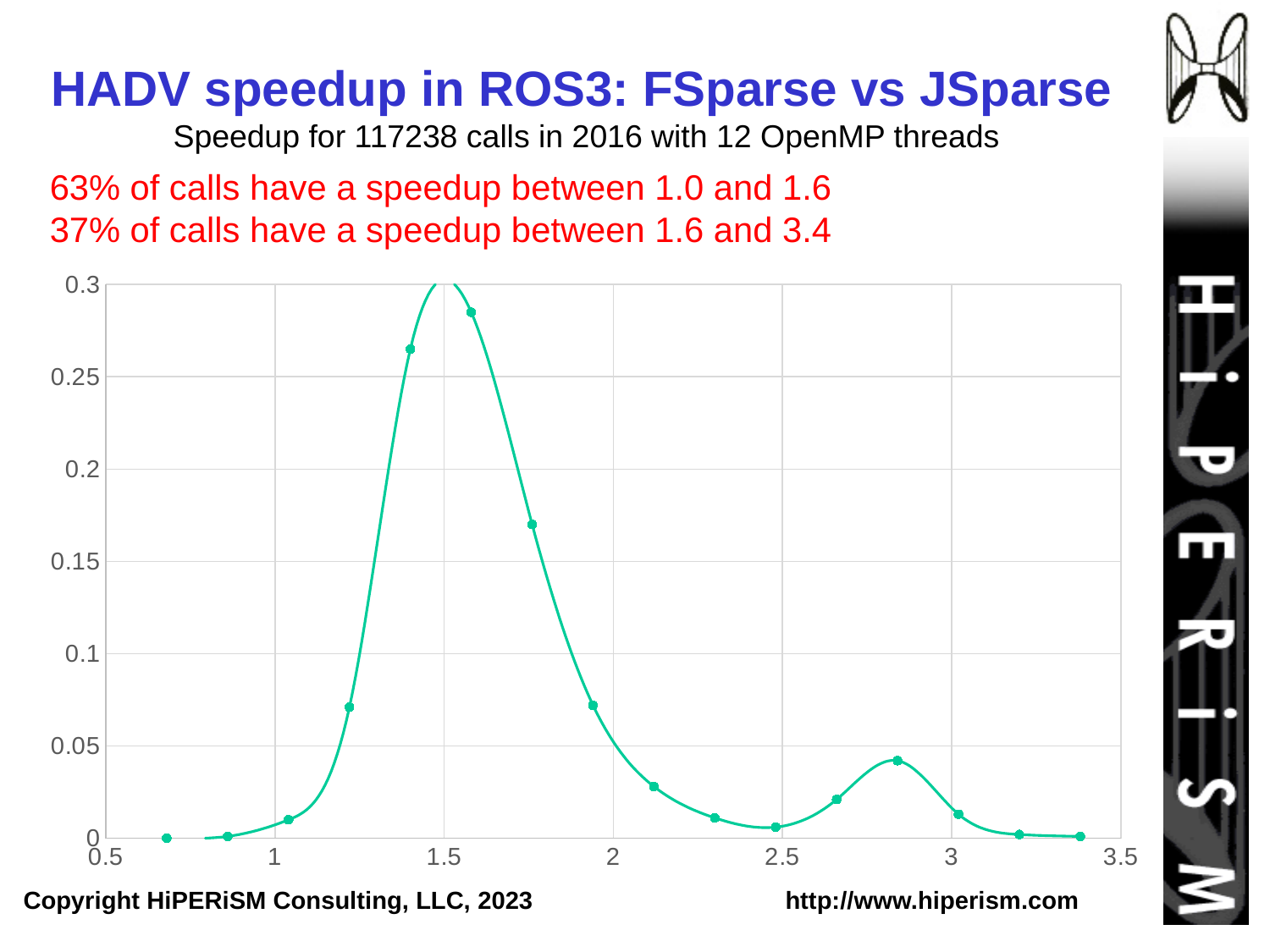
What is the title of the slide containing the chart? HADV speedup in ROS3: FSparse vs JSparse Is the value of the plotted point just below x = 1.25 greater or less than 0.1? less Do the plotted values rise or fall as x increases from 1.6 to 2.5? fall Is the value of the plotted point near x = 2.5 greater or less than 0.05? less Which is larger: the plotted value near x = 2.85 or the plotted value near x = 2.5? the value near x = 2.85 Is the value of the highest plotted point greater or less than 0.25? greater According to the chart subtitle, how many OpenMP threads were used? 12 Do the plotted values rise or fall as x increases from 1.0 to 1.5? rise Which is larger: the plotted value near x = 1.4 or the plotted value near x = 1.75? the value near x = 1.4 What kind of chart is shown on the slide? line chart